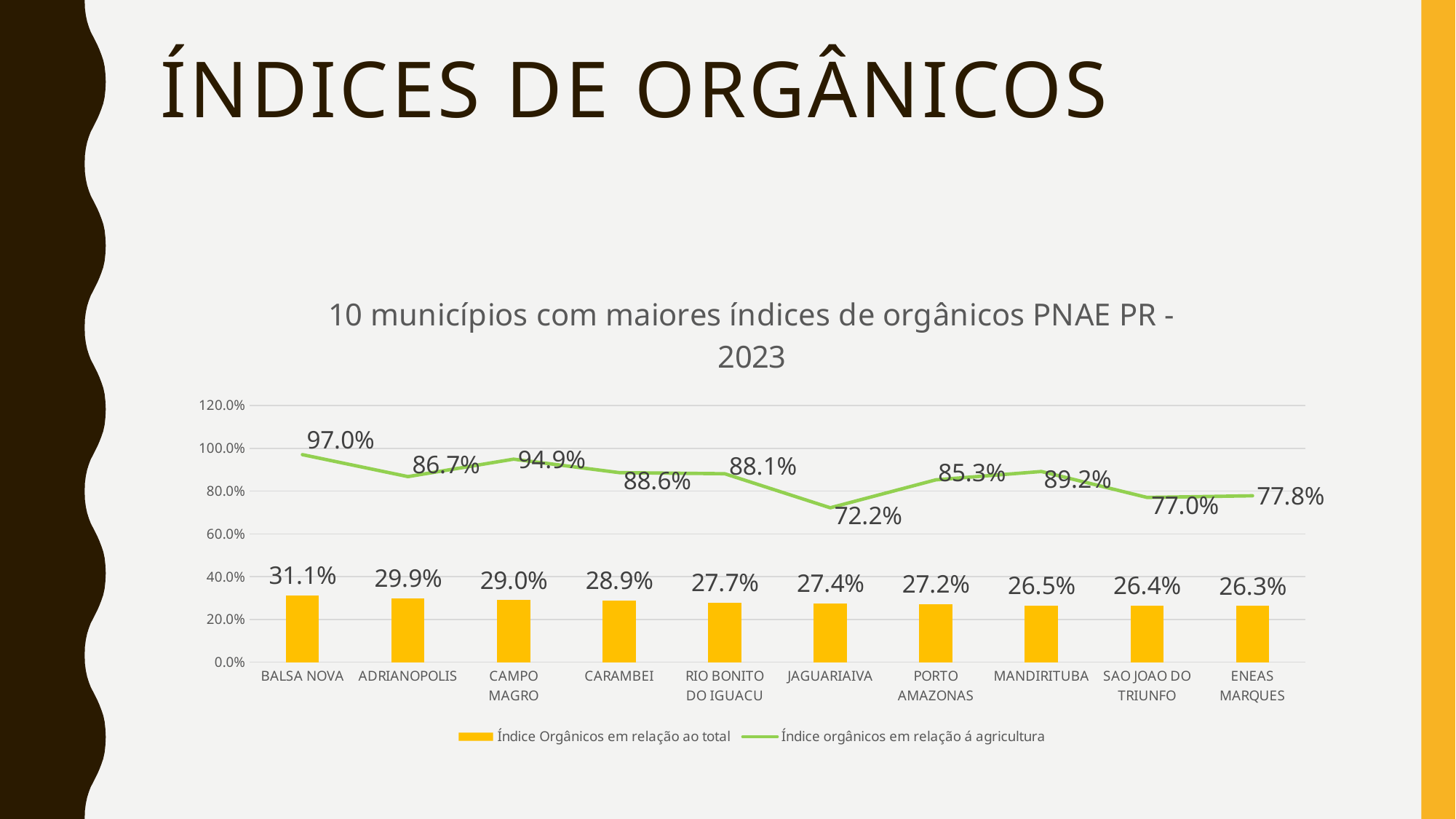
Do the 'Índice Orgânicos em relação ao total' bar values rise or fall from left to right? Fall What is the value of 'Índice Orgânicos em relação ao total' for BALSA NOVA? 31.1% How many municipalities are shown on the x axis? 10 What is the title of the chart? 10 municípios com maiores índices de orgânicos PNAE PR - 2023 Which municipality has the lowest 'Índice orgânicos em relação á agricultura'? JAGUARIAIVA What is the value of 'Índice orgânicos em relação á agricultura' for JAGUARIAIVA? 72.2% Which municipality has the highest 'Índice orgânicos em relação á agricultura'? BALSA NOVA Which is larger: the 'Índice orgânicos em relação á agricultura' for CAMPO MAGRO or for MANDIRITUBA? CAMPO MAGRO How many series does the legend list? 2 Which municipality has the lowest 'Índice Orgânicos em relação ao total'? ENEAS MARQUES What kind of chart is this? Combined bar and line chart What is the difference between the 'Índice orgânicos em relação á agricultura' values for BALSA NOVA and JAGUARIAIVA? 24.8%